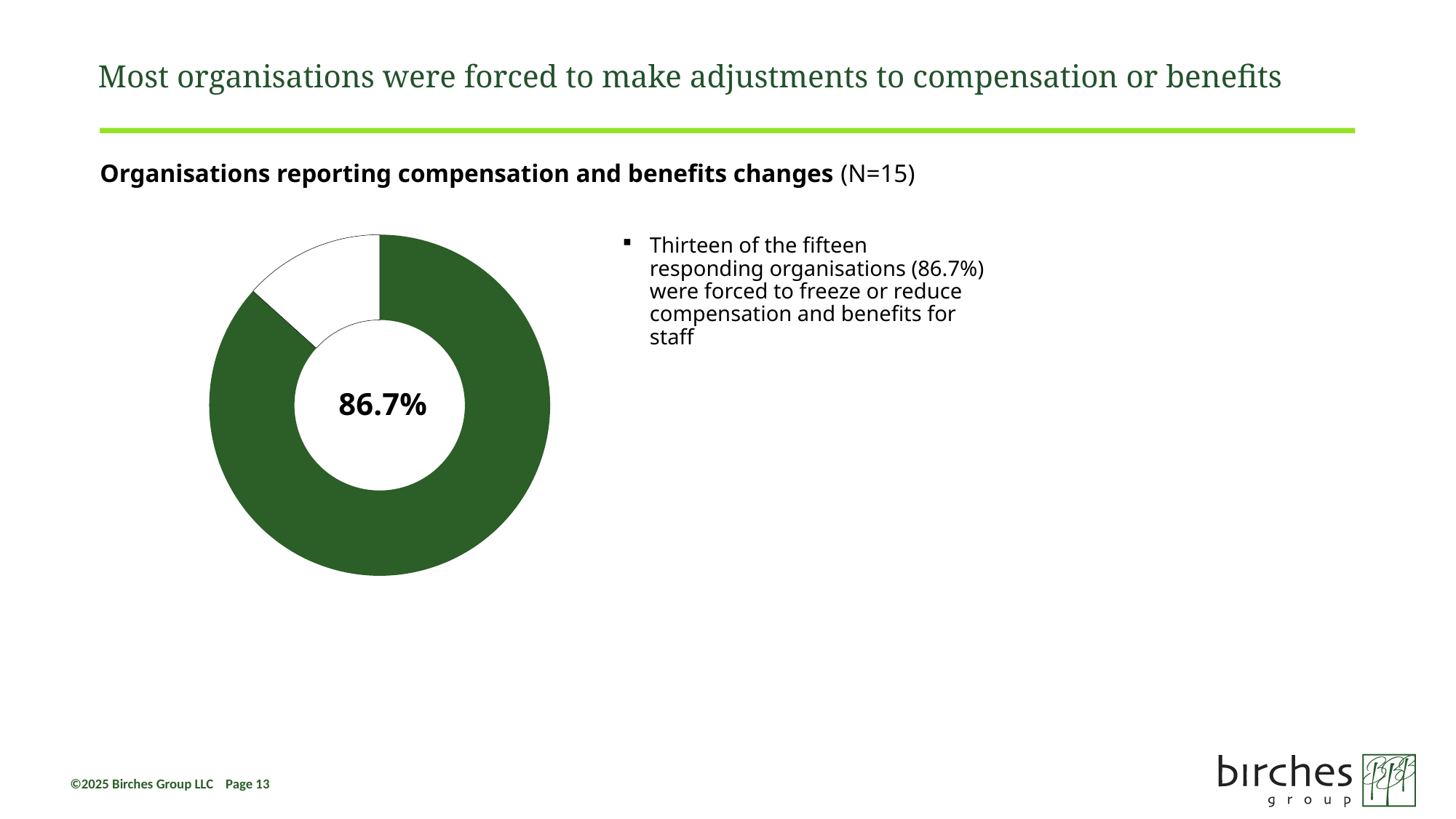
What percentage is printed in the centre of the donut chart? 86.7% What is the title of the chart? Organisations reporting compensation and benefits changes How many segments does the donut chart have? 2 Which segment of the donut chart is larger, the green one or the white one? The green one What sample size (N) is stated next to the chart title? N=15 Is the value shown in the donut chart greater or less than 50%? greater What share of the donut chart does the green segment represent? 86.7% What kind of chart is shown on the slide? Pie chart (donut)